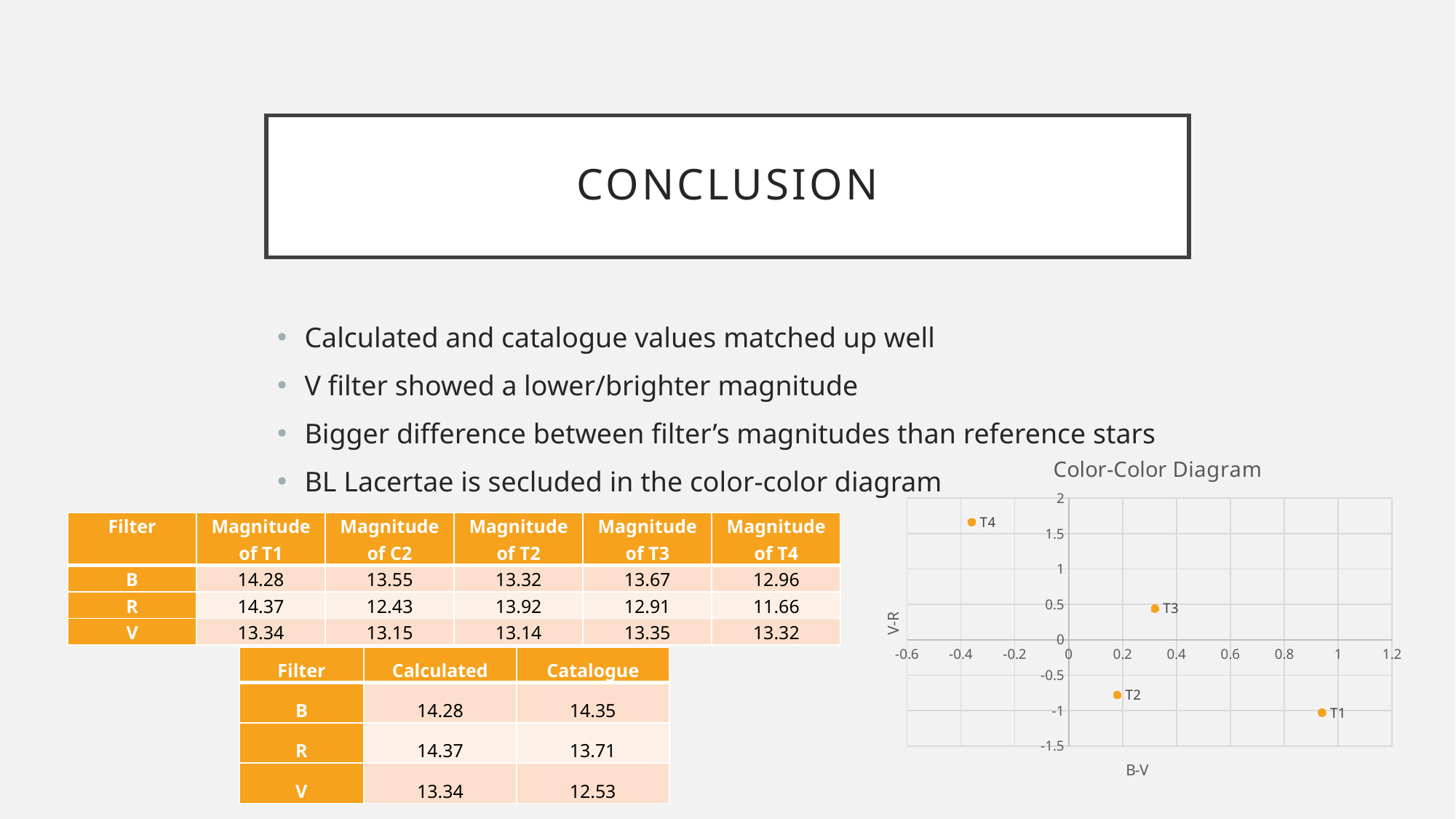
In the Color-Color Diagram, which point has a larger V-R value, T3 or T2? T3 What is the label of the vertical axis in the Color-Color Diagram? V-R What is the label of the horizontal axis in the Color-Color Diagram? B-V In the Color-Color Diagram, is the V-R value for T2 greater or less than -0.5? less In the Color-Color Diagram, which point has the highest V-R value? T4 In the Color-Color Diagram, which point has the lowest V-R value? T1 In the Color-Color Diagram, which point has the lowest B-V value? T4 In the Color-Color Diagram, is the V-R value for T4 greater or less than 1.5? greater How many data points are plotted in the Color-Color Diagram? 4 In the Color-Color Diagram, is the B-V value for T1 greater or less than 0.8? greater What kind of chart is the Color-Color Diagram? scatter chart In the Color-Color Diagram, which point has the highest B-V value? T1